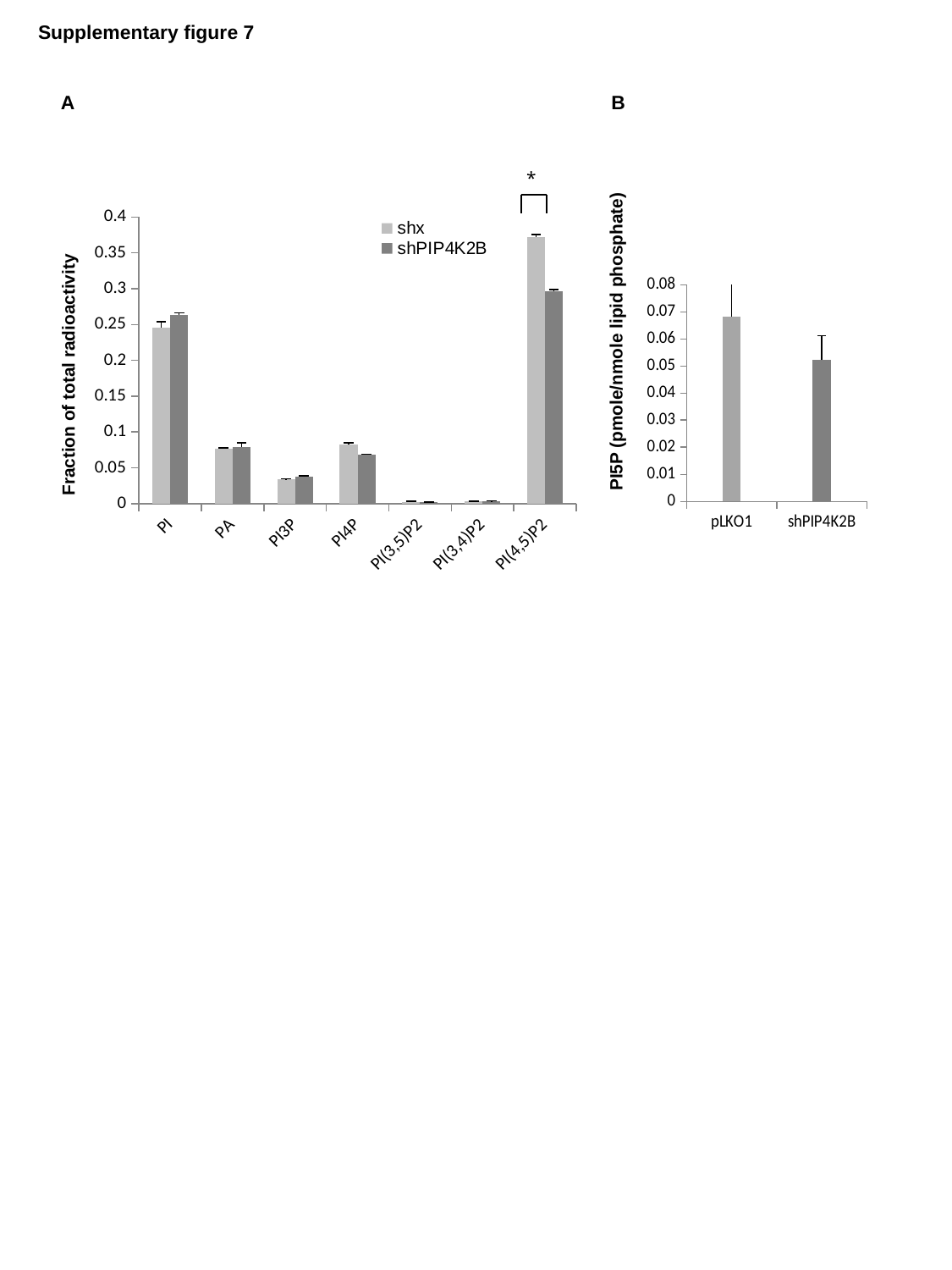
In chart A (left), for PI(4,5)P2, which series has the larger value, shx or shPIP4K2B? shx In chart A (left), which category has the highest bar? PI(4,5)P2 In chart A (left), is the shx value for PI3P greater or less than 0.05? less In chart A (left), what kind of chart is shown? bar chart In chart B (right), which category has the higher value, pLKO1 or shPIP4K2B? pLKO1 In chart B (right), how many categories are shown on the x axis? 2 In chart A (left), is the shPIP4K2B value for PI greater or less than 0.25? greater In chart A (left), how many series does the legend list? 2 In chart A (left), how many lipid categories are shown on the x axis? 7 In chart A (left), for PI4P, which series has the larger value, shx or shPIP4K2B? shx In chart B (right), is the value for pLKO1 greater or less than 0.06? greater